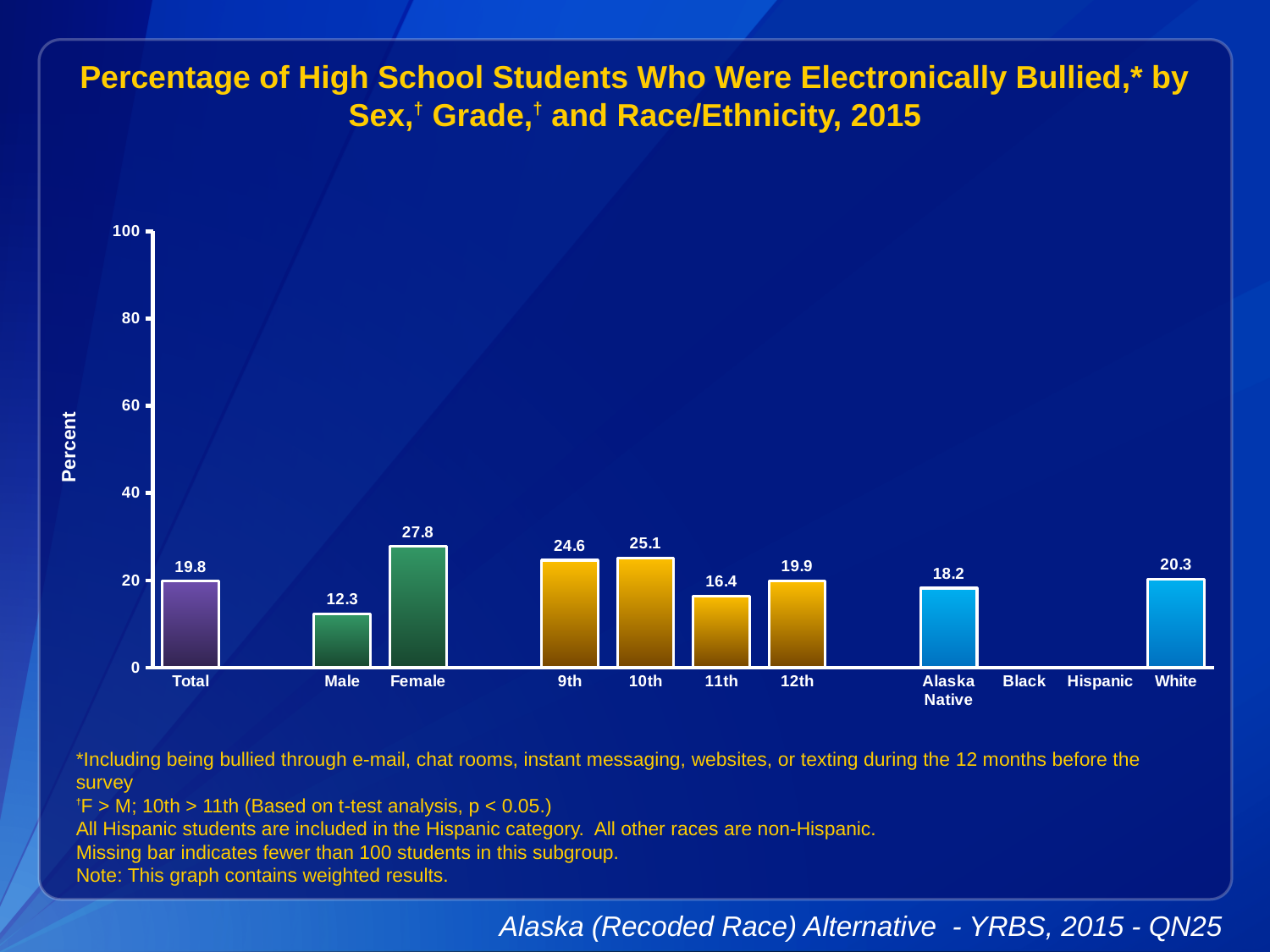
How many categories are labelled on the x axis? 11 What is the value for Alaska Native? 18.2 What is the value for Female? 27.8 What kind of chart is shown? bar chart What is the label of the y axis? Percent What is the difference between the Female and Male values? 15.5 Which is larger, the value for 10th or the value for 11th? 10th Is the value for 9th greater or less than 20? greater Which category with a plotted bar has the lowest value? Male What is the difference between the 12th and 11th grade values? 3.5 What is the value for Total? 19.8 Which category has the highest value? Female